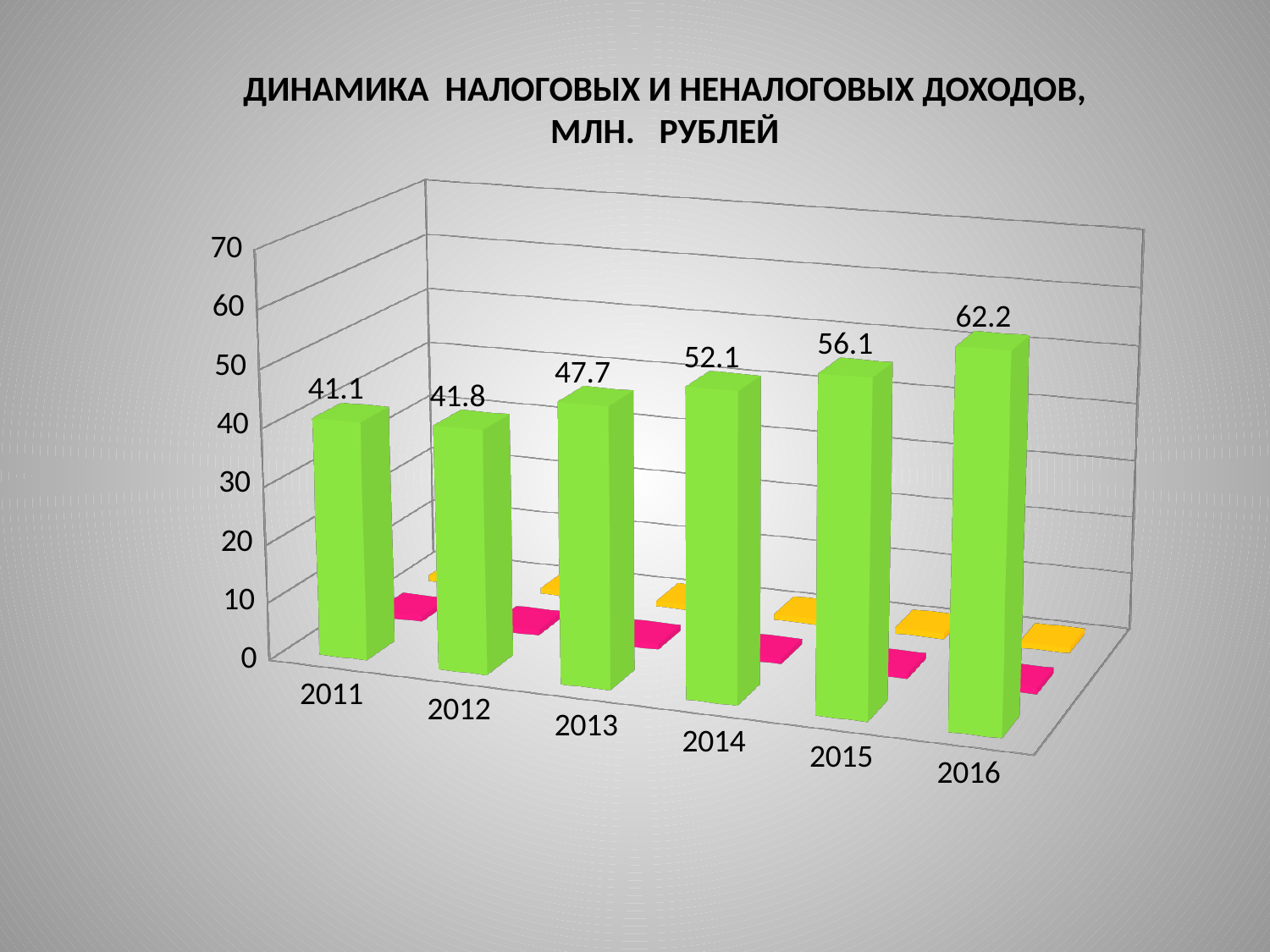
What is the value of the green bar for 2016? 62.2 Which year has the highest green bar? 2016 Is the green bar value for 2016 greater or less than 60? greater What is the value of the green bar for 2015? 56.1 What kind of chart is shown on the slide? bar chart What is the value of the green bar for 2011? 41.1 Which is larger, the green bar value for 2014 or for 2013? 2014 What is the value of the green bar for 2013? 47.7 How many years are shown on the x axis? 6 Which year has the lowest green bar? 2011 Do the green bar values rise or fall from 2011 to 2016? rise What is the difference between the green bar values for 2016 and 2011? 21.1